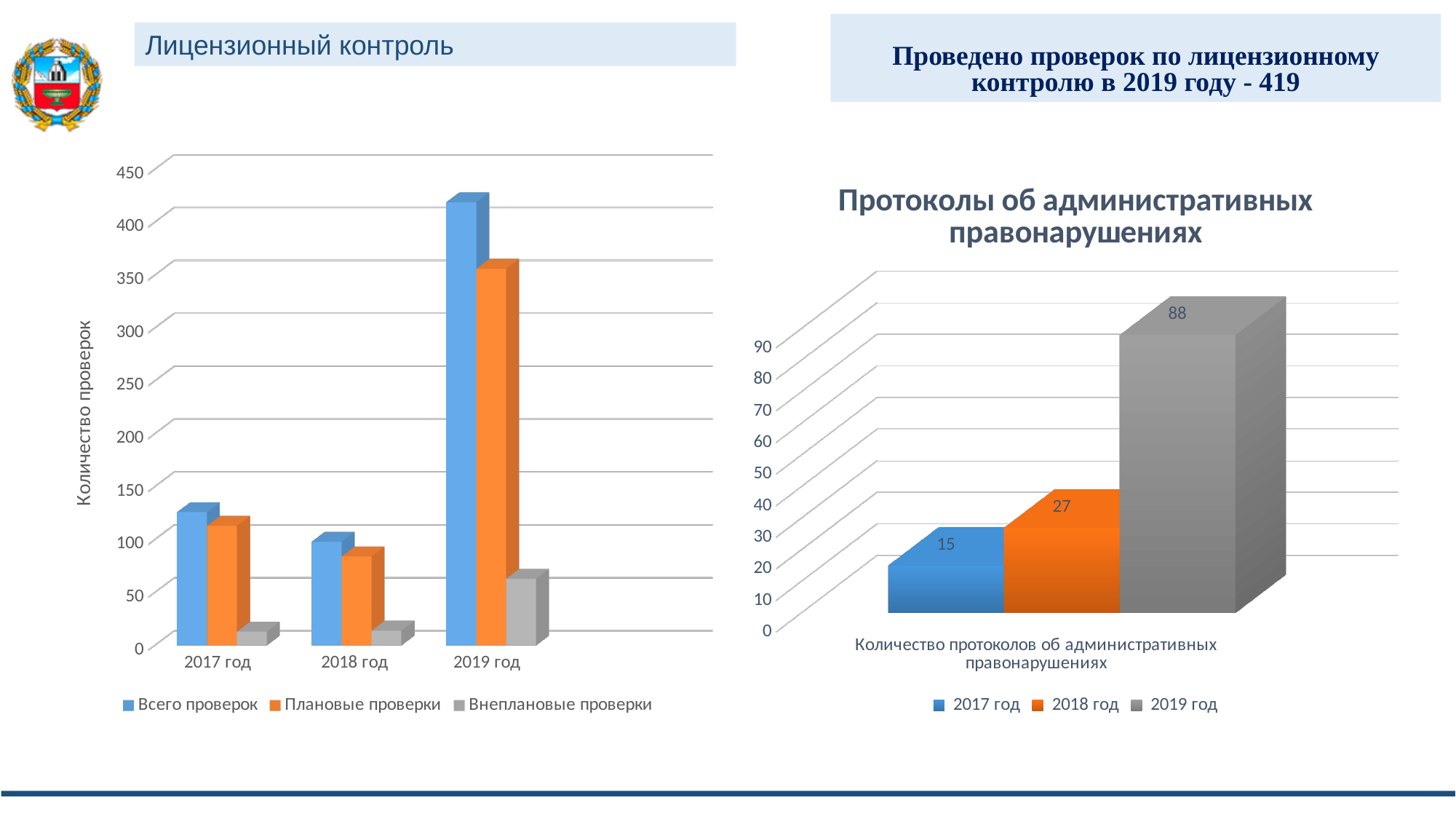
In the chart titled 'Протоколы об административных правонарушениях', what is the difference between the values for 2019 год and 2018 год? 61 What kind of chart is the left chart? bar chart In the chart titled 'Протоколы об административных правонарушениях', do the values rise or fall from 2017 год to 2019 год? rise In the left chart, which year has the highest value of 'Всего проверок'? 2019 год In the chart titled 'Протоколы об административных правонарушениях', which year has the highest value? 2019 год How many series does the legend of the chart titled 'Протоколы об административных правонарушениях' list? 3 In the left chart, is the value of 'Внеплановые проверки' for 2017 год greater or less than 50? less In the chart titled 'Протоколы об административных правонарушениях', what is the value for 2019 год? 88 In the chart titled 'Протоколы об административных правонарушениях', which year has the lowest value? 2017 год In the left chart, is the value of 'Всего проверок' for 2019 год greater or less than 400? greater In the chart titled 'Протоколы об административных правонарушениях', what is the value for 2017 год? 15